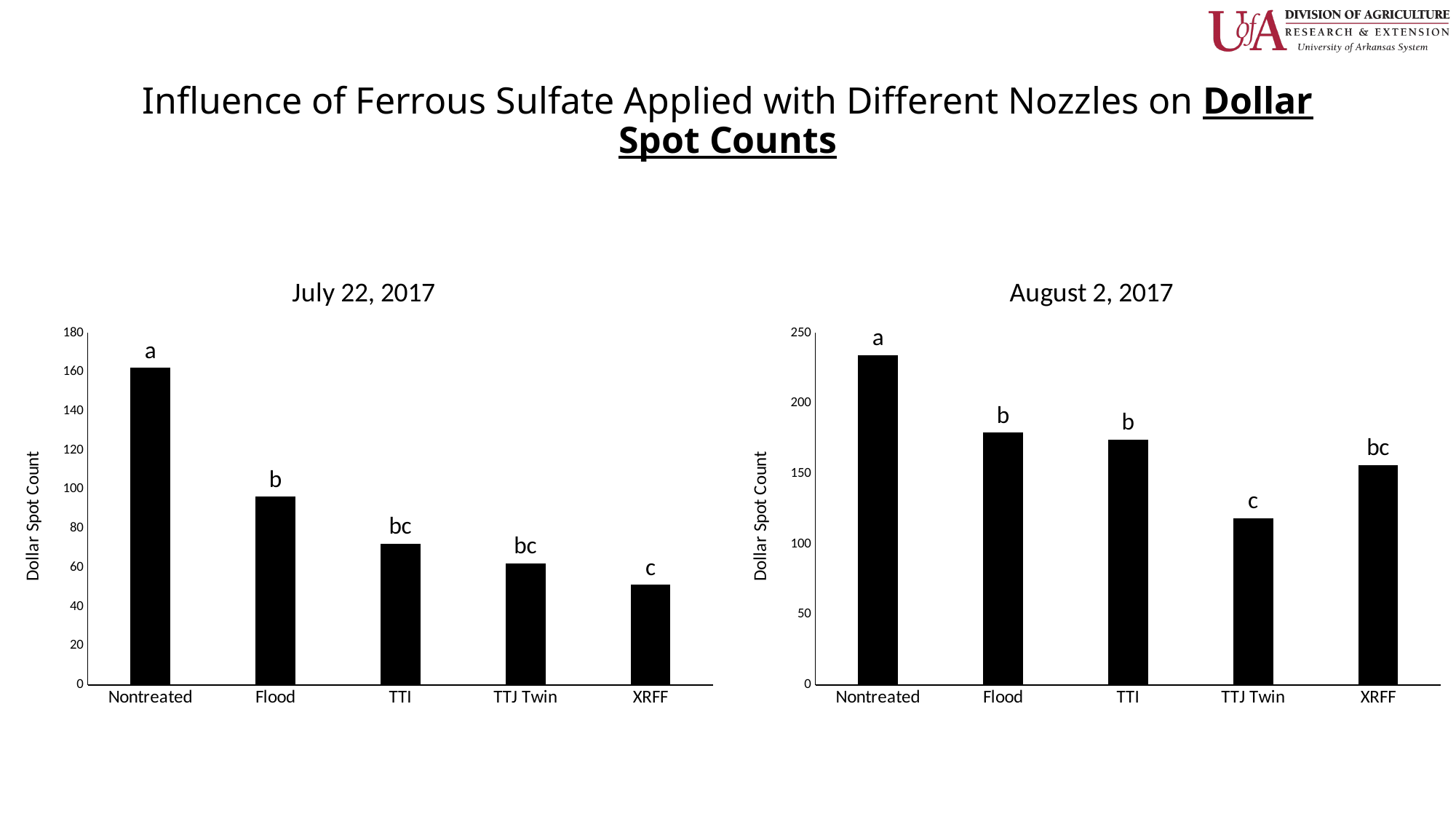
How many categories are shown on the x axis of the July 22, 2017 chart? 5 In the July 22, 2017 chart, do the values rise or fall from left to right along the x axis? fall In the August 2, 2017 chart, is the value for Flood greater or less than 200? less In the August 2, 2017 chart, which category has the highest Dollar Spot Count? Nontreated In the July 22, 2017 chart, is the value for XRFF greater or less than 60? less In the August 2, 2017 chart, is the value for TTJ Twin greater or less than 150? less What kind of chart is the August 2, 2017 chart? bar chart In the July 22, 2017 chart, which category has the highest Dollar Spot Count? Nontreated In the August 2, 2017 chart, which category has the lowest Dollar Spot Count? TTJ Twin In the July 22, 2017 chart, which is larger, the value for Flood or the value for TTI? Flood In the July 22, 2017 chart, which category has the lowest Dollar Spot Count? XRFF